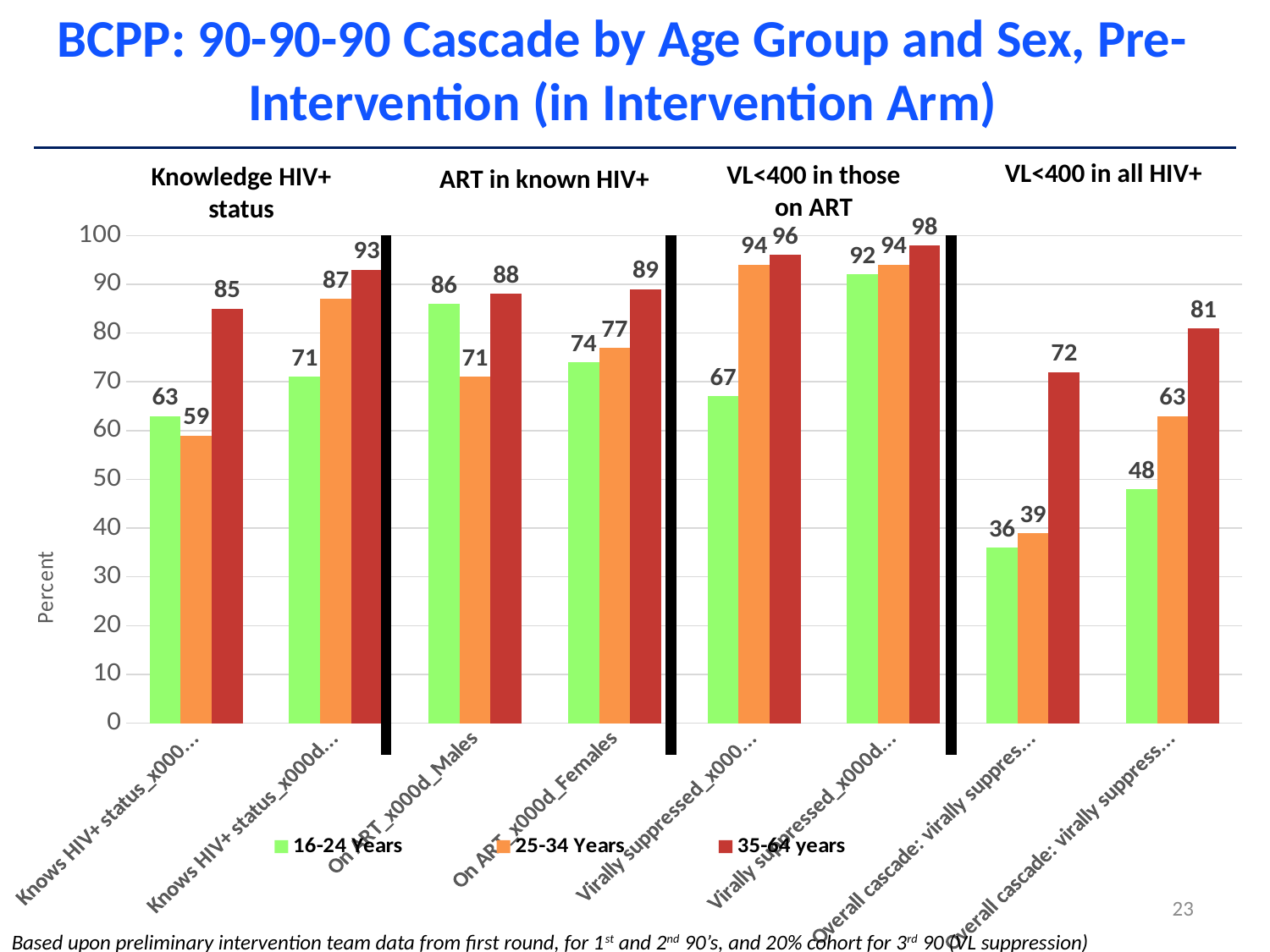
What is the value for the 35-64 years series in the On ART Females group? 89 What is the value for the 25-34 Years series in the On ART Males group? 71 What is the value for the 16-24 Years series in the On ART Males group? 86 In the first group under the 'VL<400 in all HIV+' section, what is the value for the 35-64 years series? 72 In the second group under the 'VL<400 in those on ART' section, what is the value for the 35-64 years series? 98 Which series has the highest value in the On ART Females group? 35-64 years What kind of chart is shown on the slide? bar chart Which series has the lowest value in the first group under the 'Knowledge HIV+ status' section? 25-34 Years In the On ART Males group, which is larger: the 16-24 Years value or the 25-34 Years value? 16-24 Years How many groups of bars are plotted on the chart? 8 How many series does the legend list? 3 What is the difference between the 35-64 years and 16-24 Years values in the On ART Females group? 15